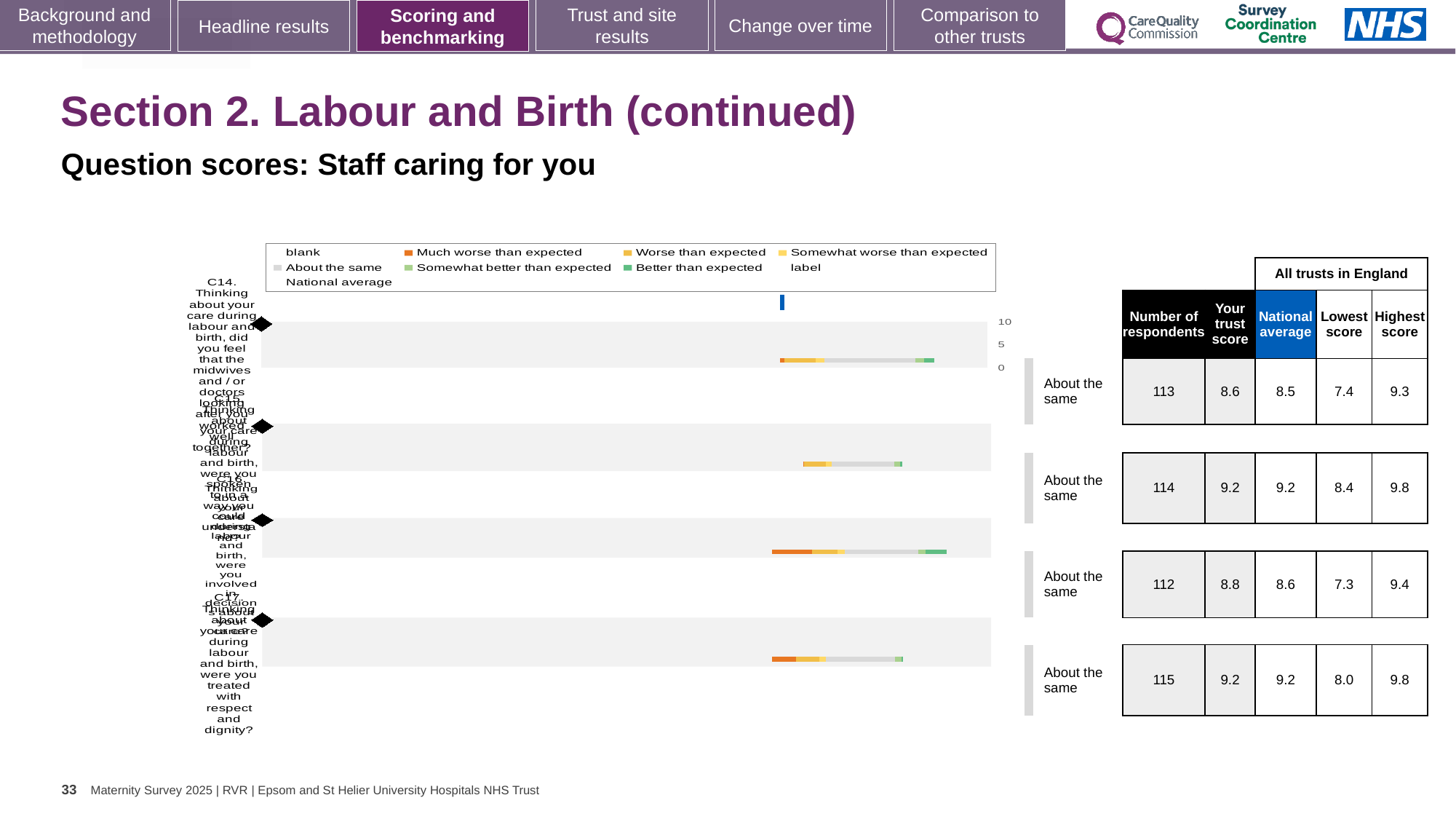
How many questions (categories) are plotted in the chart? 4 What is the number of respondents for question C17 (the fourth row)? 115 What is the lowest score among all trusts in England for question C15 (the second row)? 8.4 For question C16, which is larger: the trust score or the national average? trust score What is the difference between the trust score and the national average for question C14? 0.1 What is the highest tick value shown on the chart's axis? 10 Is the trust score for question C15 greater or less than 5? greater Which question row has the highest number of respondents? C17 Which question row has the lowest 'Lowest score' value? C16 What is the national average for question C16 (the third row)? 8.6 What is the trust score for question C14 (the first row)? 8.6 What kind of chart is shown on the slide? bar chart